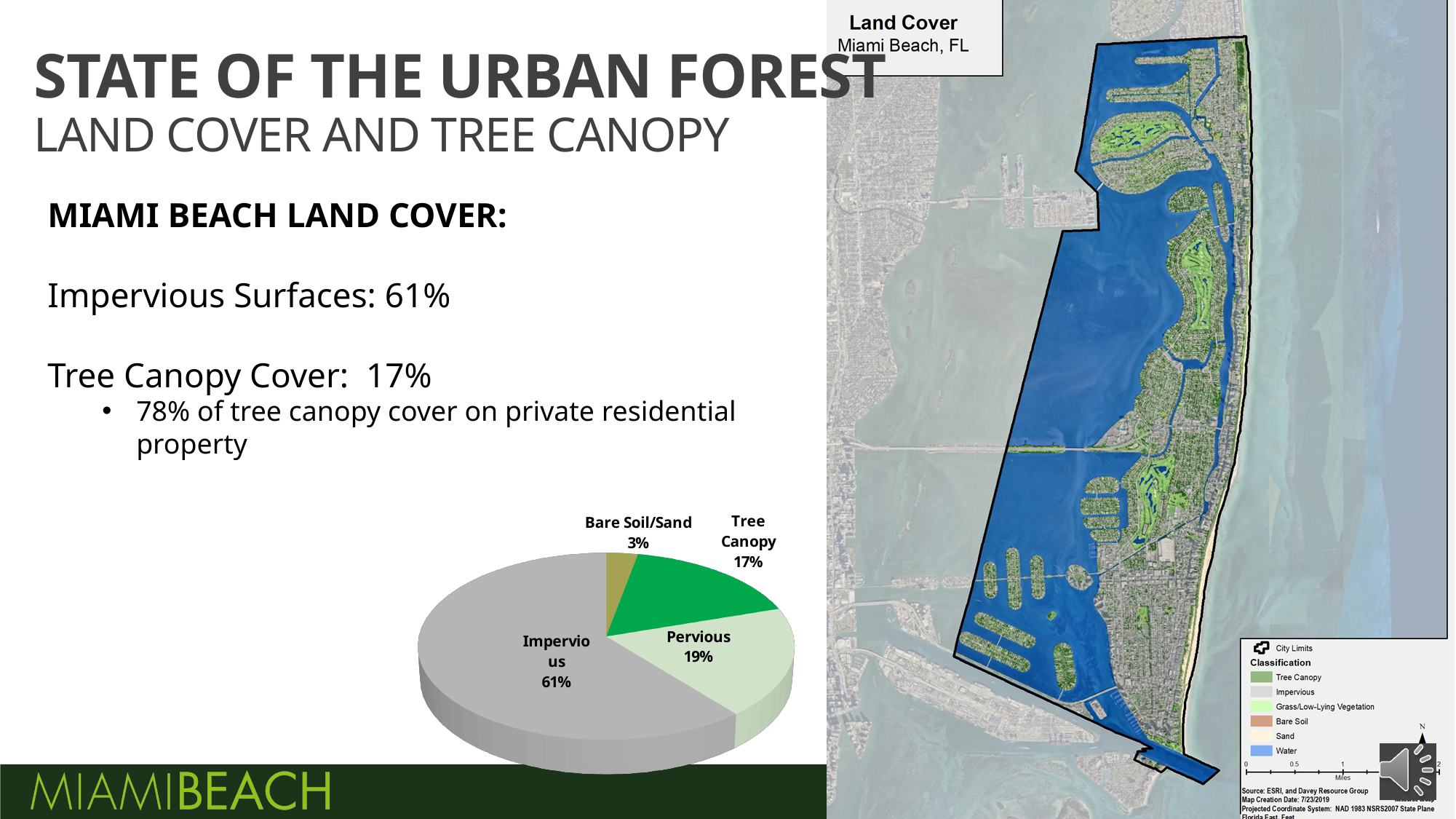
Which category has the smallest slice in the pie chart? Bare Soil/Sand What percentage of land cover is Tree Canopy in the pie chart? 17% Which category has the largest slice in the pie chart? Impervious What is the difference in percentage points between the Impervious and Tree Canopy slices? 44 Which is larger in the pie chart, Pervious or Tree Canopy? Pervious How many slices does the pie chart have? 4 What colour is the Impervious slice in the pie chart? Gray What percentage of land cover is Impervious in the pie chart? 61% What percentage of land cover is Pervious in the pie chart? 19% What is the combined share of the Pervious and Tree Canopy slices? 36% What percentage of land cover is Bare Soil/Sand in the pie chart? 3% What kind of chart is shown at the bottom left of the slide? Pie chart